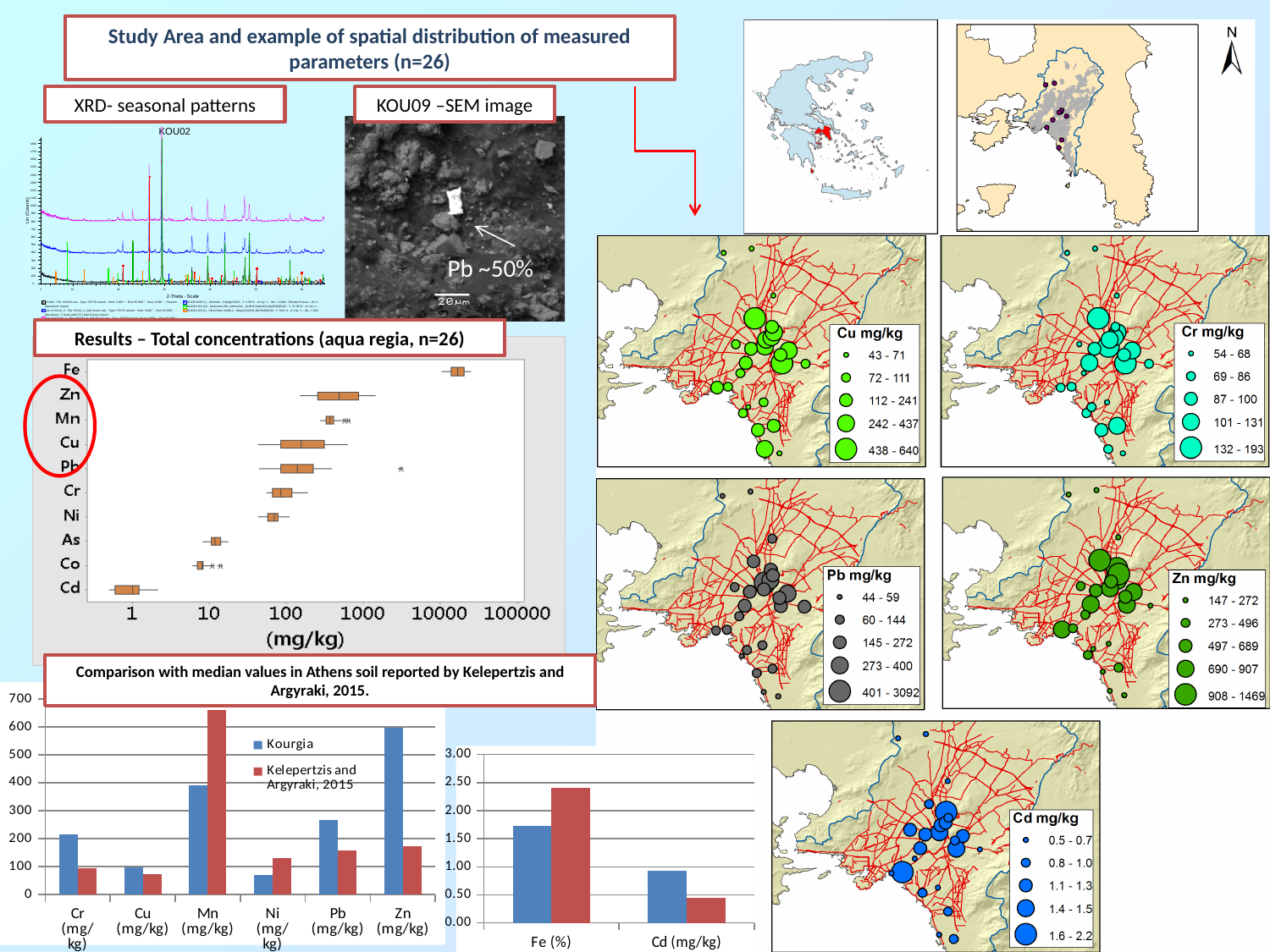
In the comparison bar chart at the bottom left, is the Kourgia value for Zn greater or less than 500? greater In the comparison bar chart at the bottom left, which is larger for Pb: the Kourgia value or the Kelepertzis and Argyraki, 2015 value? Kourgia In the 'Results – Total concentrations (aqua regia, n=26)' box plot, how many elements are listed on the y axis? 10 In the comparison bar chart at the bottom left, what are the two series named in the legend? Kourgia; Kelepertzis and Argyraki, 2015 In the comparison bar chart at the bottom left, which is larger for Ni: the Kourgia value or the Kelepertzis and Argyraki, 2015 value? Kelepertzis and Argyraki, 2015 In the comparison bar chart at the bottom left, is the Kelepertzis and Argyraki, 2015 value for Mn greater or less than 600? greater In the small bar chart showing Fe (%) and Cd (mg/kg), is the Kourgia (blue) value for Fe (%) greater or less than 2.00? less In the comparison bar chart at the bottom left, which element has the highest Kelepertzis and Argyraki, 2015 value? Mn (mg/kg) In the comparison bar chart at the bottom left, how many series does the legend list? 2 In the comparison bar chart at the bottom left, how many element categories are shown on the x axis? 6 In the comparison bar chart at the bottom left, which element has the highest Kourgia value? Zn (mg/kg) In the small bar chart showing Fe (%) and Cd (mg/kg), which series has the larger value for Cd (mg/kg): the blue (Kourgia) or the red (Kelepertzis and Argyraki, 2015)? Kourgia (blue)